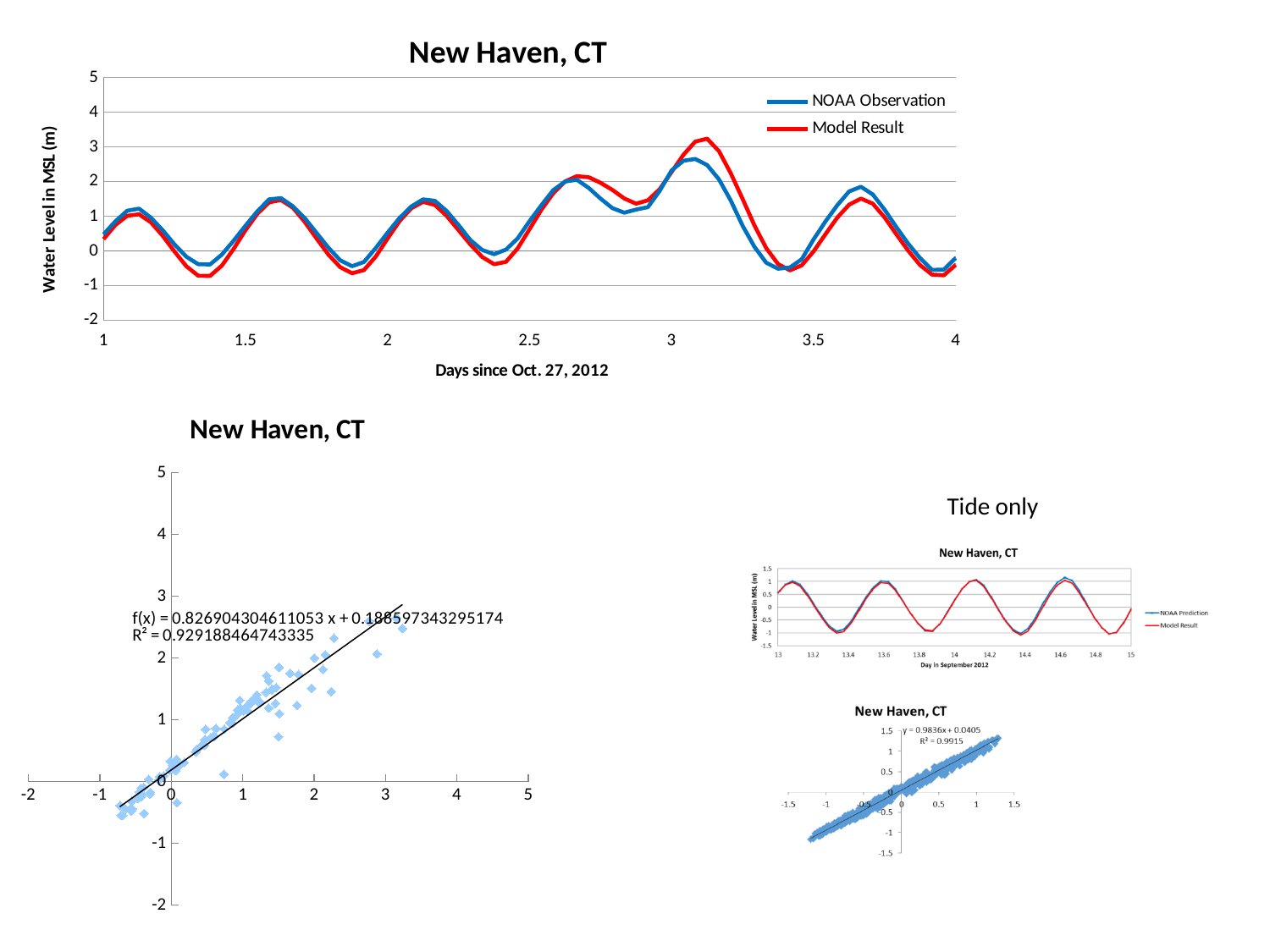
What are the two legend entries of the small line chart under "Tide only"? NOAA Prediction, Model Result What type of chart is the top chart titled "New Haven, CT"? line chart In the top line chart, is the highest value of the NOAA Observation series greater or less than 3? less In the top line chart, is the lowest value of the Model Result series greater or less than 0? less What trendline equation is printed on the bottom-left scatter chart? f(x) = 0.826904304611053 x + 0.188597343295174 What type of chart is the bottom-left chart titled "New Haven, CT"? scatter chart How many series does the legend of the top line chart list? 2 In the top line chart, is the highest value of the Model Result series greater or less than 3? greater What R² value is printed on the small scatter chart at the bottom right under "Tide only"? 0.9915 What is the x-axis title of the top line chart? Days since Oct. 27, 2012 In the top line chart, around day 3.1, which series reaches the higher peak, NOAA Observation or Model Result? Model Result What R² value is printed on the bottom-left scatter chart? 0.929188464743335